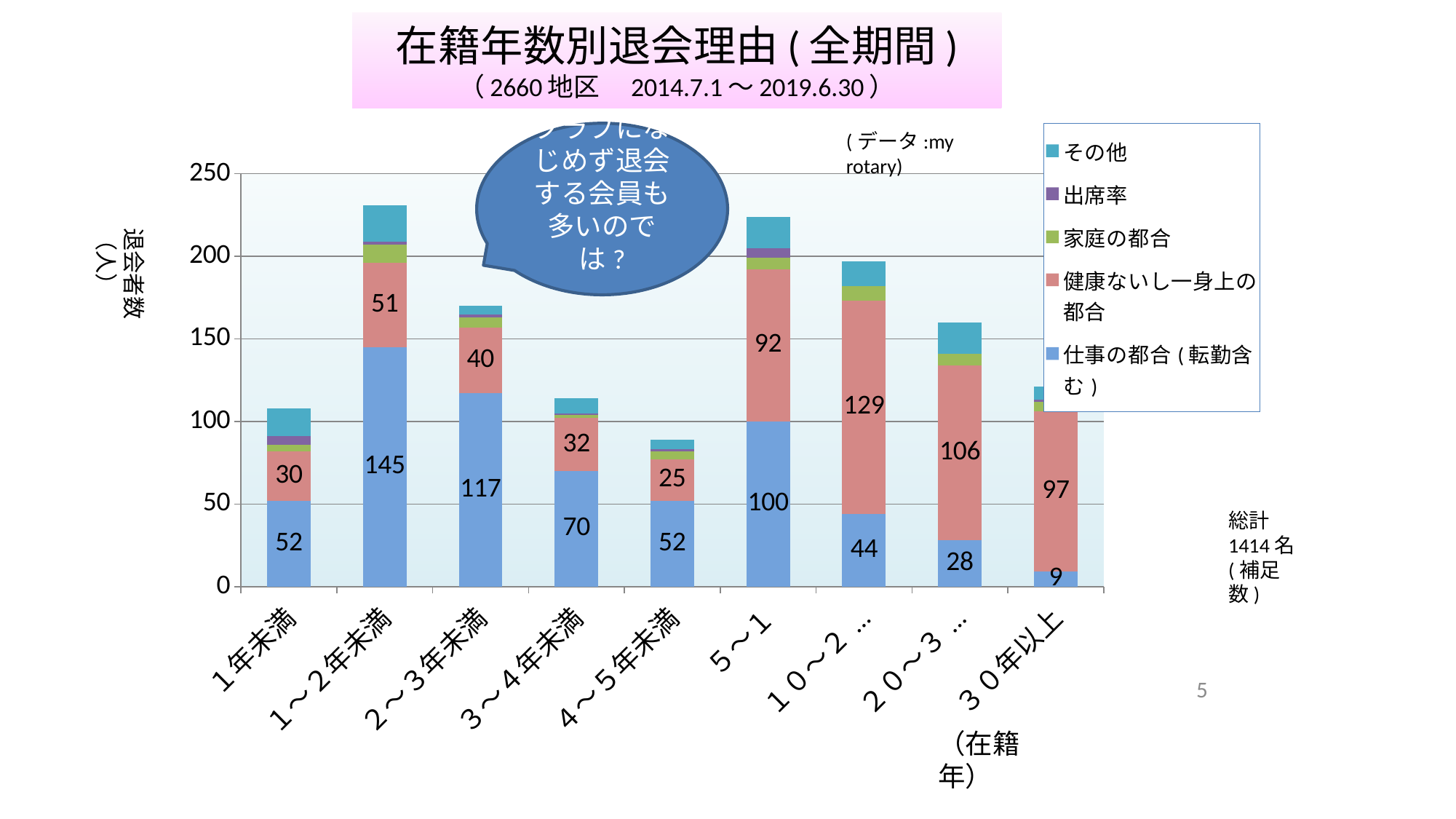
How many series does the legend list? 5 What is the value of 仕事の都合(転勤含む) for the 1～2年未満 category? 145 Which is larger: the 仕事の都合(転勤含む) value for 2～3年未満 or for 3～4年未満? 2～3年未満 Which category has the highest value for 仕事の都合(転勤含む)? 1～2年未満 Which category has the lowest value for 仕事の都合(転勤含む)? 30年以上 For the 30年以上 category, how much larger is the 健康ないし一身上の都合 value than the 仕事の都合(転勤含む) value? 88 What is the value of 健康ないし一身上の都合 for the 30年以上 category? 97 What is the value of 仕事の都合(転勤含む) for the 3～4年未満 category? 70 Is the total height of the 1～2年未満 bar greater or less than 200? greater How many categories are shown on the x axis? 9 Is the total height of the 4～5年未満 bar greater or less than 100? less For the 1年未満 category, what is the difference between the 仕事の都合(転勤含む) value and the 健康ないし一身上の都合 value? 22